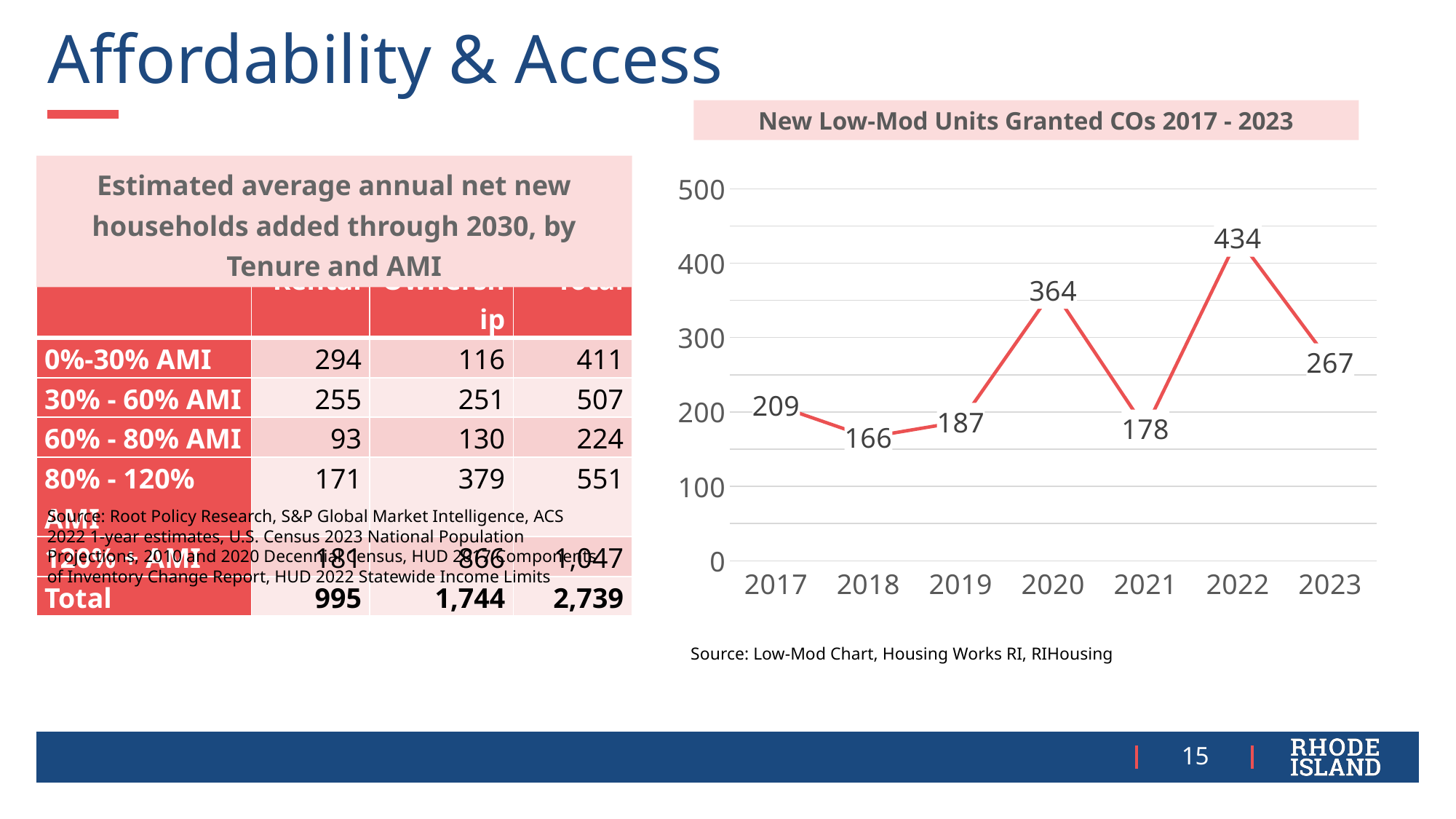
What type of chart is "New Low-Mod Units Granted COs 2017 - 2023"? Line chart In the "New Low-Mod Units Granted COs 2017 - 2023" chart, what is the value for 2018? 166 In the "New Low-Mod Units Granted COs 2017 - 2023" chart, which year has the lowest value? 2018 In the "New Low-Mod Units Granted COs 2017 - 2023" chart, which year has the highest value? 2022 In the "New Low-Mod Units Granted COs 2017 - 2023" chart, what is the value for 2023? 267 In the "New Low-Mod Units Granted COs 2017 - 2023" chart, what is the difference between the values for 2017 and 2019? 22 In the "New Low-Mod Units Granted COs 2017 - 2023" chart, which is larger, the value for 2020 or the value for 2023? 2020 In the "New Low-Mod Units Granted COs 2017 - 2023" chart, what is the value for 2020? 364 In the "New Low-Mod Units Granted COs 2017 - 2023" chart, does the value rise or fall from 2022 to 2023? Fall In the "New Low-Mod Units Granted COs 2017 - 2023" chart, is the value for 2022 greater or less than 400? greater In the "New Low-Mod Units Granted COs 2017 - 2023" chart, what is the difference between the values for 2022 and 2021? 256 How many years are plotted in the "New Low-Mod Units Granted COs 2017 - 2023" chart? 7